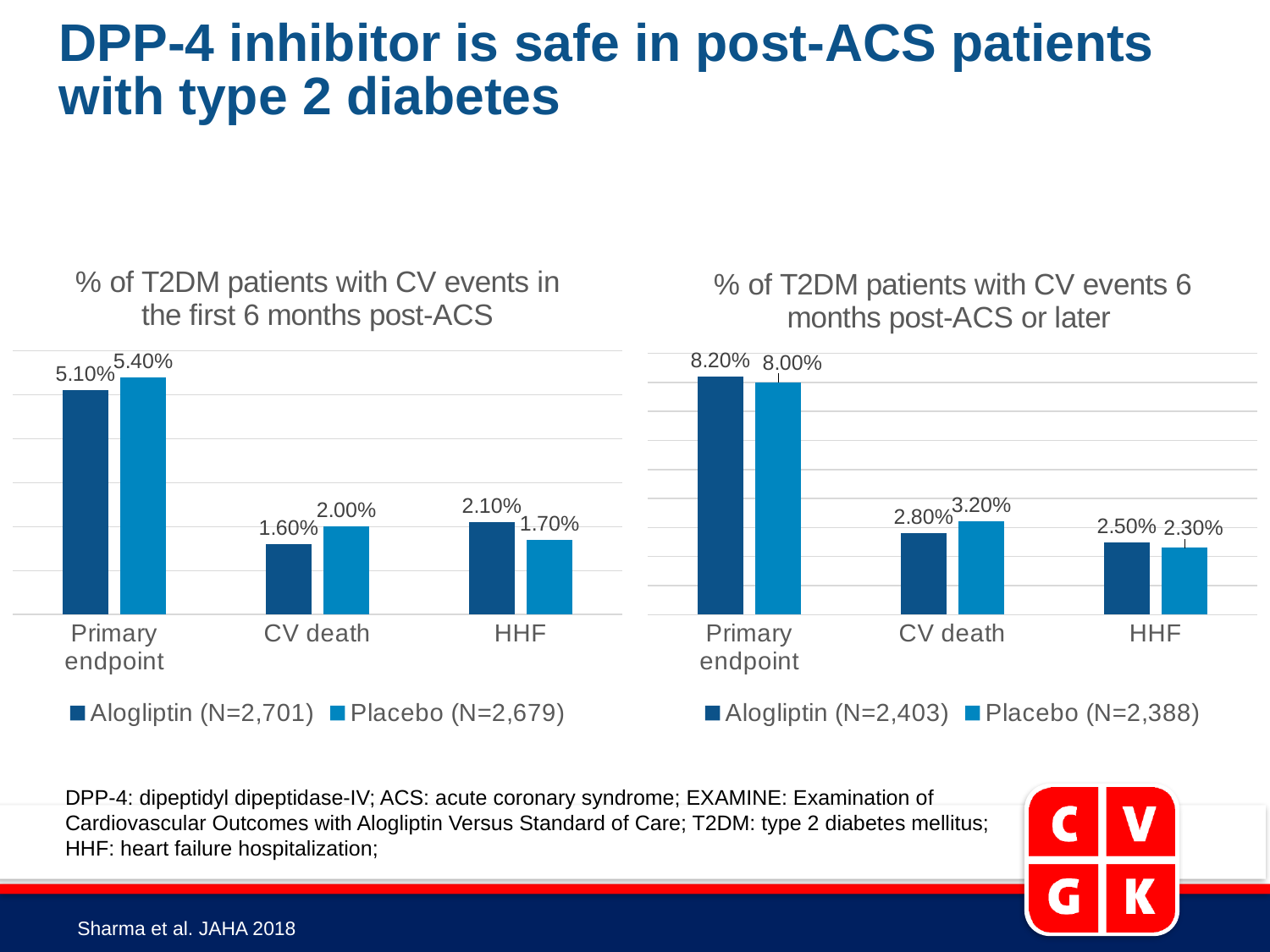
In the left chart, which is larger for HHF: Alogliptin or Placebo? Alogliptin In the chart '% of T2DM patients with CV events 6 months post-ACS or later', what is the Placebo value for the Primary endpoint? 8.00% In the right chart, which category has the lowest Alogliptin value? HHF How many series does the legend of the left chart list? 2 How many categories are shown on the x axis of the right chart? 3 In the chart '% of T2DM patients with CV events 6 months post-ACS or later', what is the Alogliptin value for HHF? 2.50% In the chart '% of T2DM patients with CV events in the first 6 months post-ACS', what is the value for Alogliptin at the Primary endpoint? 5.10% What type of chart is the '% of T2DM patients with CV events 6 months post-ACS or later' chart? Bar chart In the chart '% of T2DM patients with CV events in the first 6 months post-ACS', what is the Placebo value for CV death? 2.00% In the left chart, which category has the highest Placebo value? Primary endpoint In the left chart, what is the difference between the Placebo and Alogliptin values at the Primary endpoint? 0.30% In the right chart, what is the difference between the Placebo and Alogliptin values for CV death? 0.40%